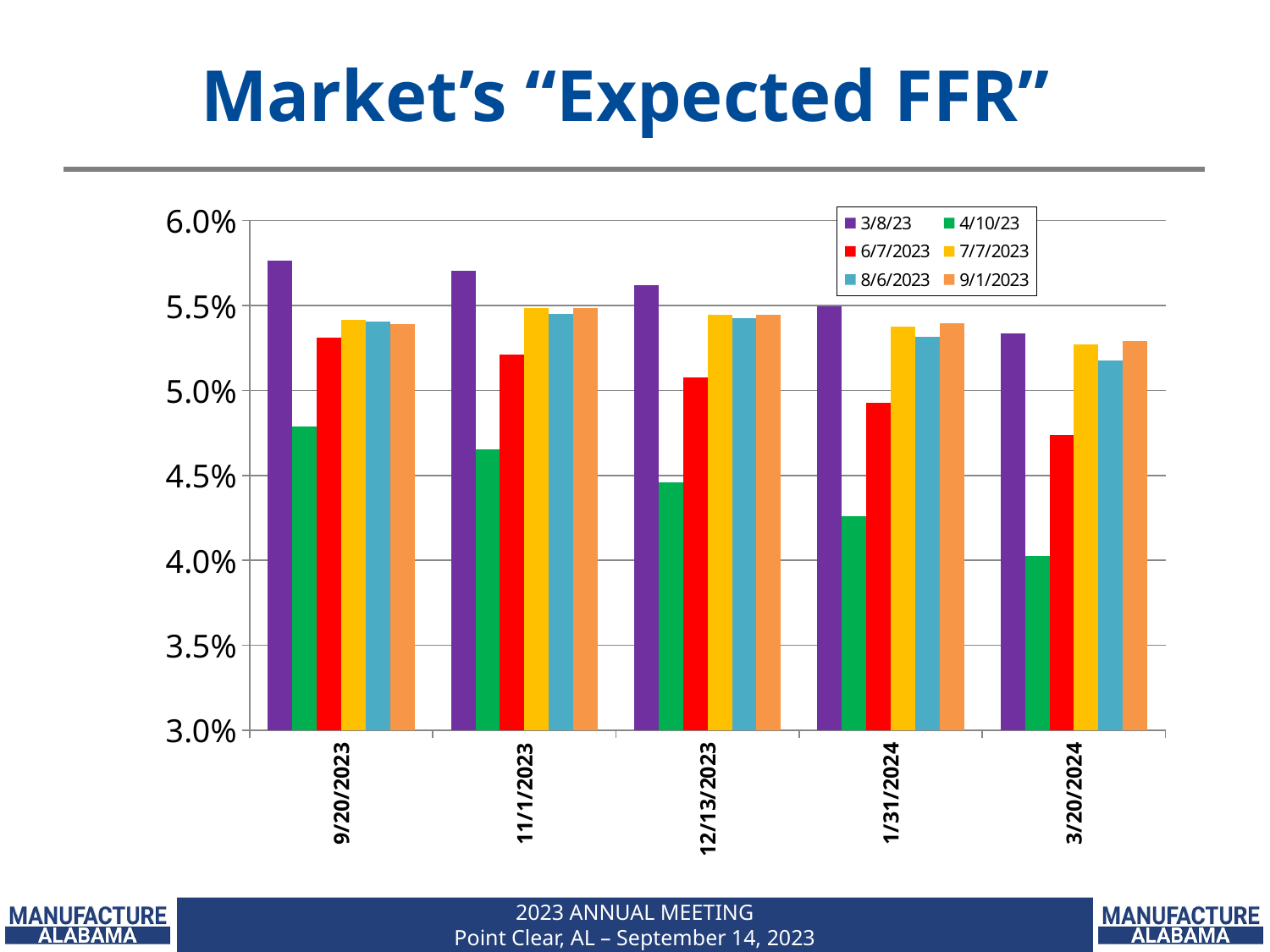
What is the title of the chart? Market's "Expected FFR" For which category is the 4/10/23 series lowest? 3/20/2024 How many categories are shown on the x axis? 5 Is the value for 4/10/23 at 1/31/2024 greater or less than 4.5%? less Which series has the highest value for 9/20/2023? 3/8/23 At 12/13/2023, which is larger: the 6/7/2023 value or the 7/7/2023 value? 7/7/2023 Is the value for 3/8/23 at 9/20/2023 greater or less than 5.5%? greater Is the value for 6/7/2023 at 3/20/2024 greater or less than 5.0%? less What kind of chart is shown on the slide? bar chart Which series has the lowest value for 3/20/2024? 4/10/23 Do the values for the 4/10/23 series rise or fall from 9/20/2023 to 3/20/2024? fall How many series does the legend list? 6